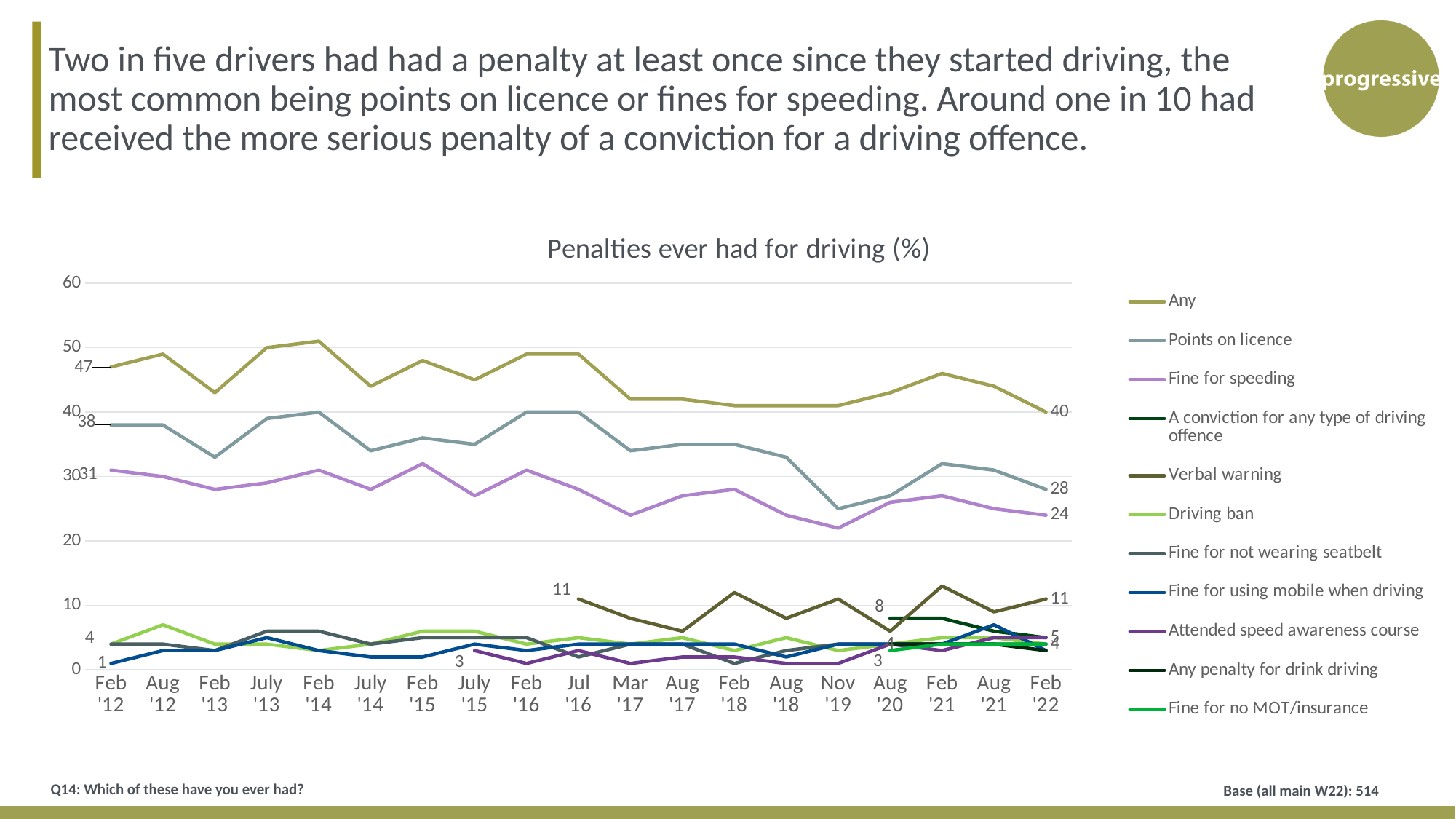
Is the value for 'Fine for speeding' at Nov '19 greater or less than 30? less What is the value for 'Fine for speeding' at Feb '12? 31 How many time points are shown on the x axis? 19 What is the title of the chart? Penalties ever had for driving (%) What type of chart is shown on the slide? Line chart How many series does the legend list? 11 What is the value for 'Points on licence' at Feb '22? 28 By how much did the value for 'Any' fall between Feb '12 and Feb '22? 7 Which series has the highest value at Feb '22? Any What is the value for 'Any' at Feb '22? 40 What is the difference between 'Points on licence' at Feb '12 and at Feb '22? 10